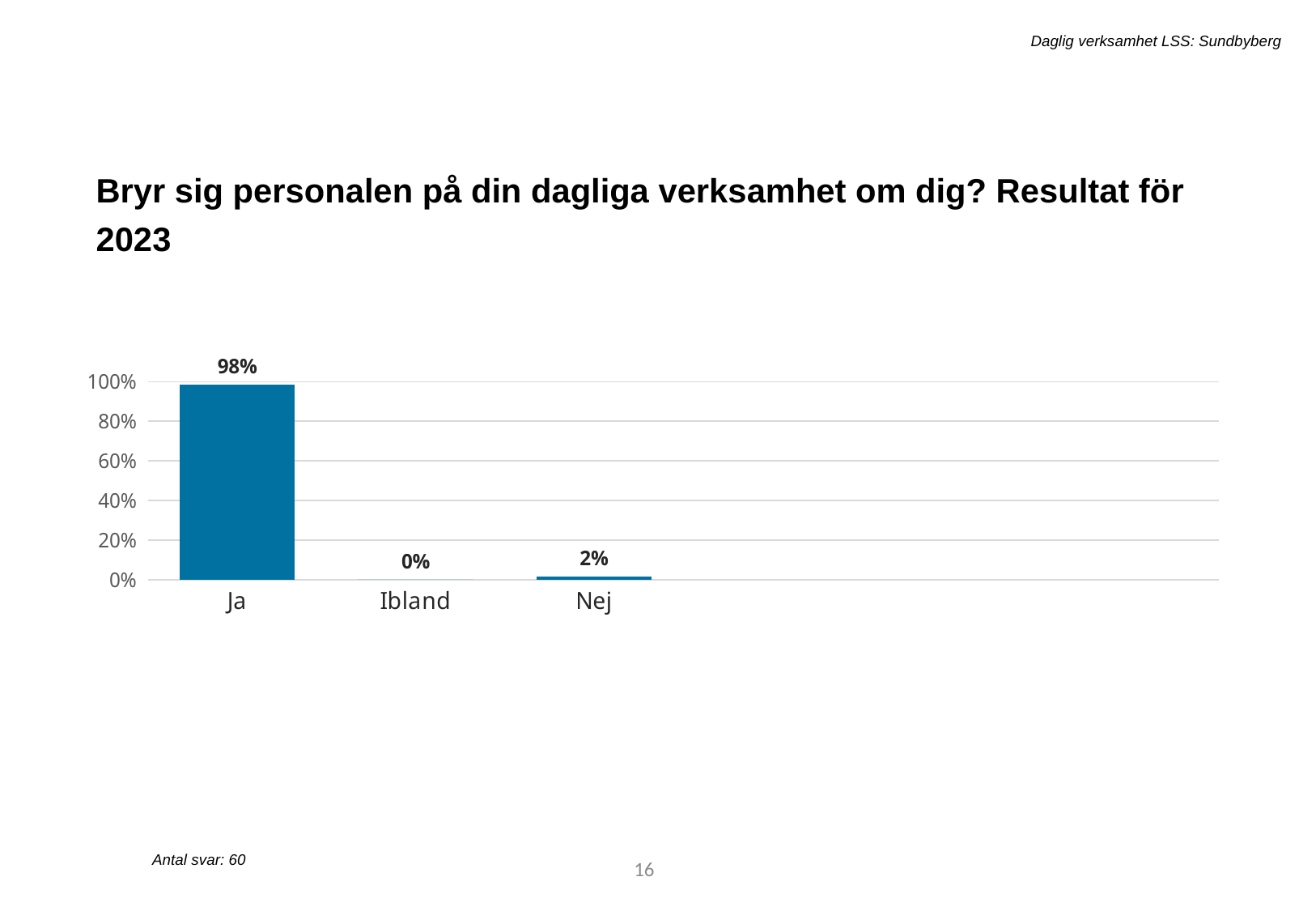
What is the difference between the values for Ja and Nej? 96% What is the title of the slide? Bryr sig personalen på din dagliga verksamhet om dig? Resultat för 2023 Which category has the highest value? Ja Which is larger, the value for Nej or the value for Ibland? Nej What is the value for Ja? 98% Which category has the lowest value? Ibland What kind of chart is shown on the slide? bar chart How many categories are shown on the x axis? 3 What is the value for Nej? 2% Is the value for Ja greater or less than 80%? greater How many responses (Antal svar) does the slide report? 60 What is the value for Ibland? 0%